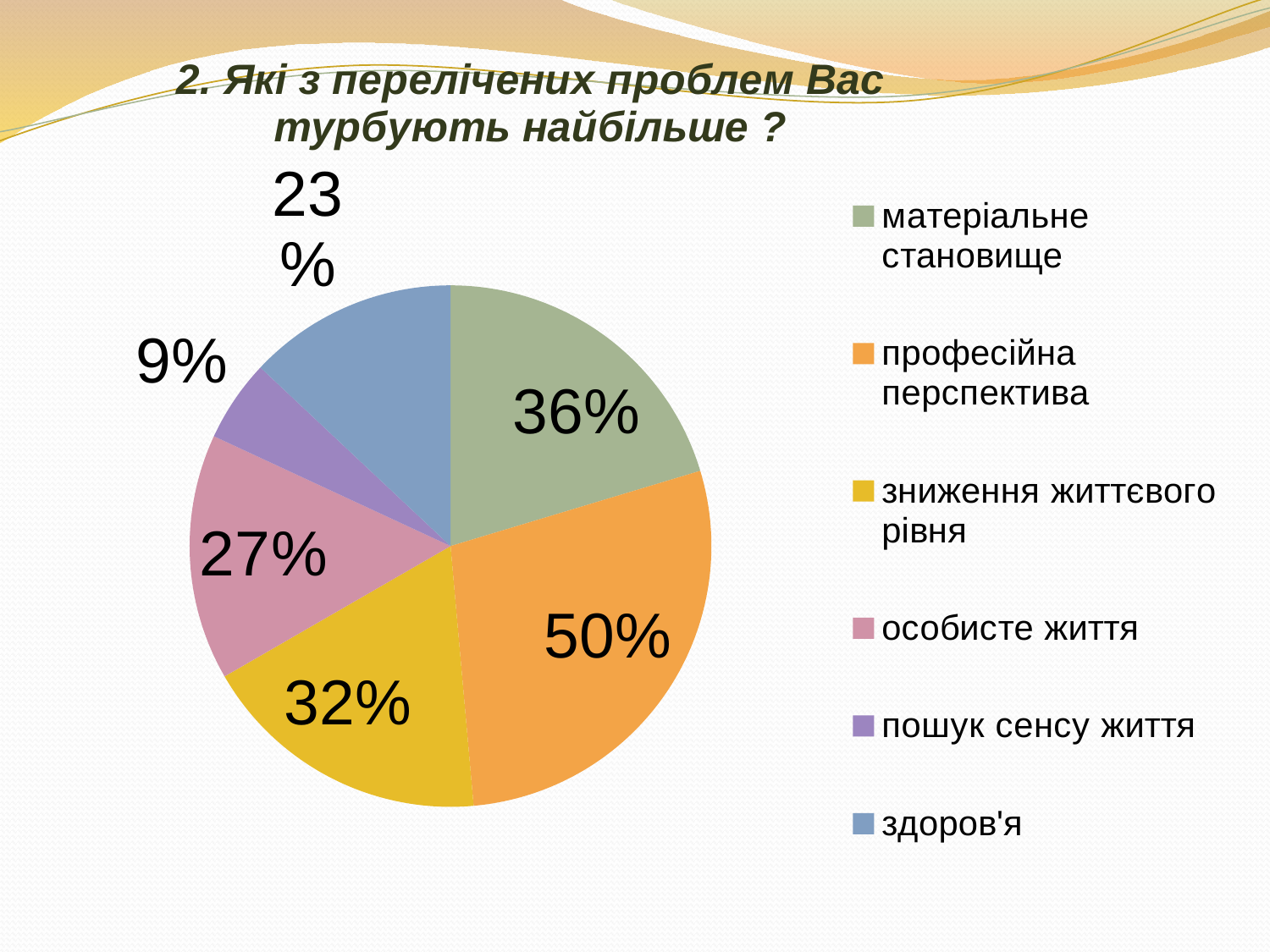
Which category has the smallest slice? пошук сенсу життя What value is shown for "матеріальне становище"? 36% What kind of chart is shown on the slide? pie chart What value is shown for "зниження життєвого рівня"? 32% What is the difference between the values for "професійна перспектива" and "матеріальне становище"? 14% What value is shown for "пошук сенсу життя"? 9% What value is shown for "професійна перспектива"? 50% What value is shown for "особисте життя"? 27% How many categories does the legend list? 6 Which is larger, the value for "особисте життя" or the value for "здоров'я"? особисте життя What value is shown for "здоров'я"? 23% Which category has the largest slice? професійна перспектива